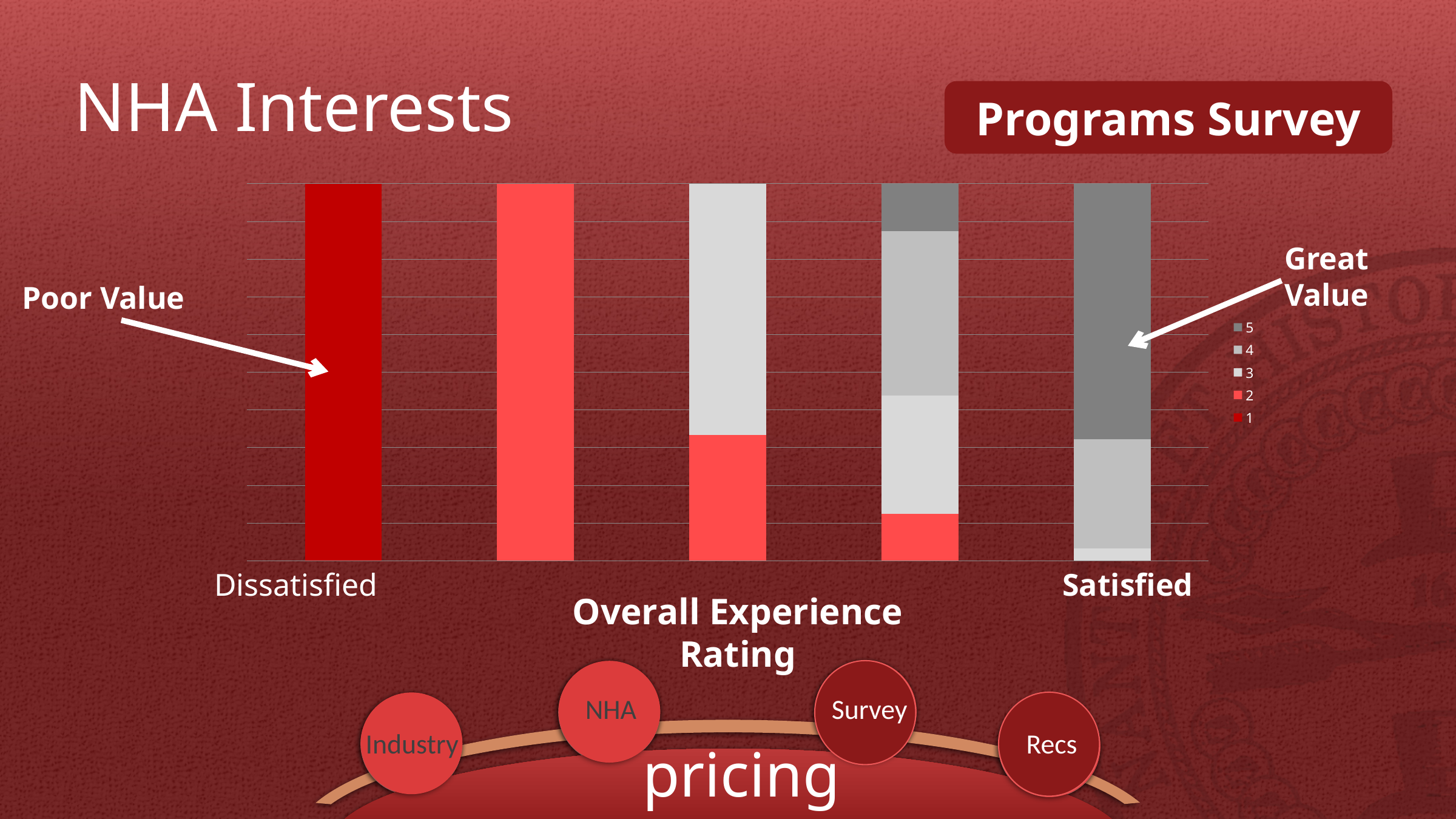
How many series does the chart legend list? 5 What kind of chart is shown on the slide? Stacked bar chart Which legend series makes up the entire second bar from the left? 2 What is the axis title shown below the bars? Overall Experience Rating Which bar does the 'Great Value' arrow point to? The rightmost (Satisfied) bar Which legend series makes up the entire leftmost (Dissatisfied) bar? 1 Which bar does the 'Poor Value' arrow point to? The leftmost (Dissatisfied) bar In the fourth bar from the left, which series has the smallest segment? Series 2 and 5 (tied) What are the entries in the chart legend, from top to bottom? 5, 4, 3, 2, 1 In the fourth bar from the left, which series has the largest segment? 4 In the middle bar, which segment is larger: series 3 or series 2? Series 3 How many bars are plotted in the chart? 5